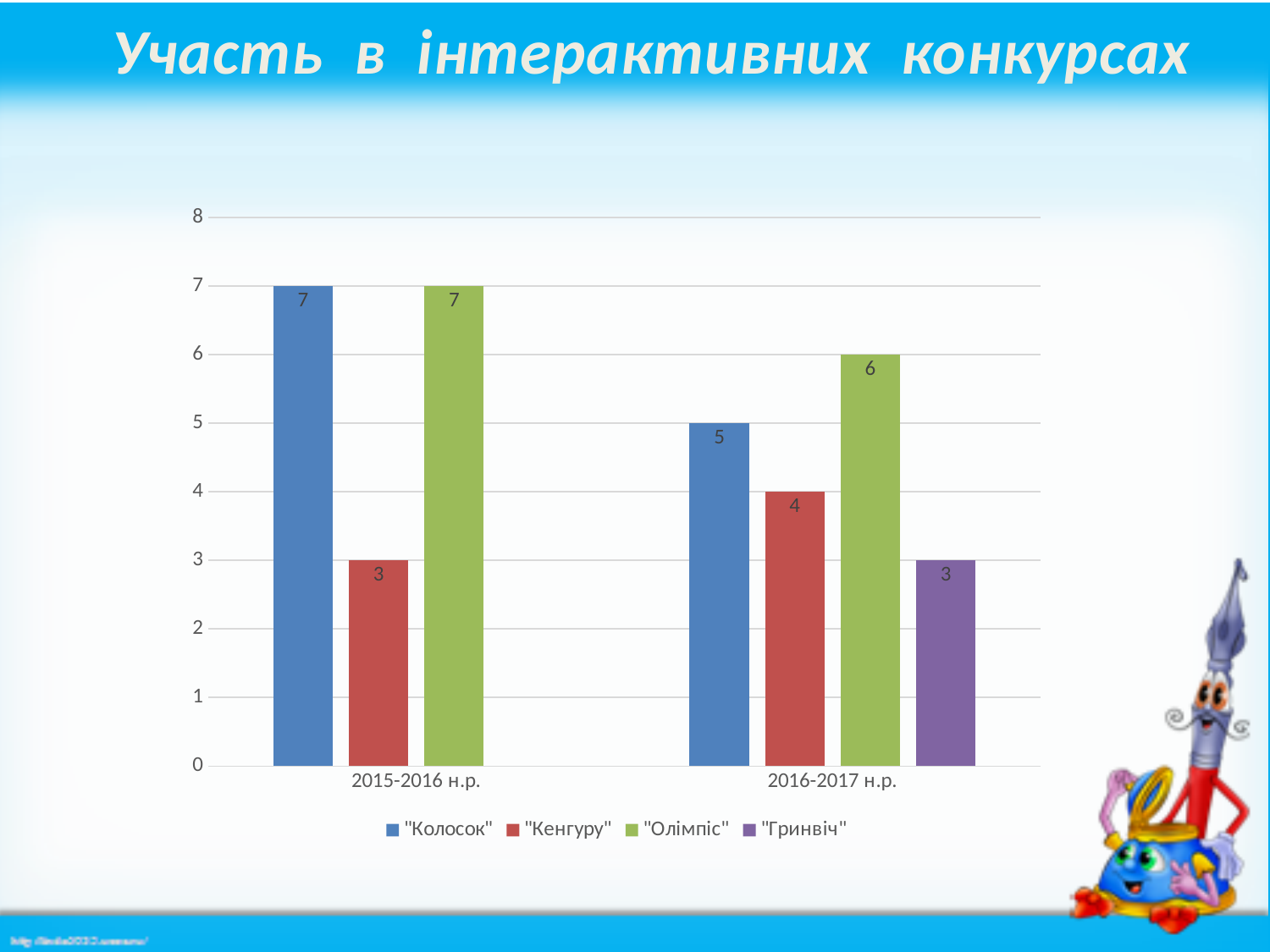
Which is larger: "Кенгуру" in 2015-2016 н.р. or "Кенгуру" in 2016-2017 н.р.? "Кенгуру" in 2016-2017 н.р. What is the value for "Колосок" in 2015-2016 н.р.? 7 How many categories are shown on the x axis? 2 How many series does the legend list? 4 What is the value for "Кенгуру" in 2016-2017 н.р.? 4 Which series has the highest value in 2016-2017 н.р.? "Олімпіс" Which series has the lowest value in 2015-2016 н.р.? "Кенгуру" What is the title of the chart? Участь в інтерактивних конкурсах What is the value for "Олімпіс" in 2016-2017 н.р.? 6 What is the difference between the "Колосок" values for 2015-2016 н.р. and 2016-2017 н.р.? 2 What is the value for "Гринвіч" in 2016-2017 н.р.? 3 What kind of chart is shown on the slide? Bar chart